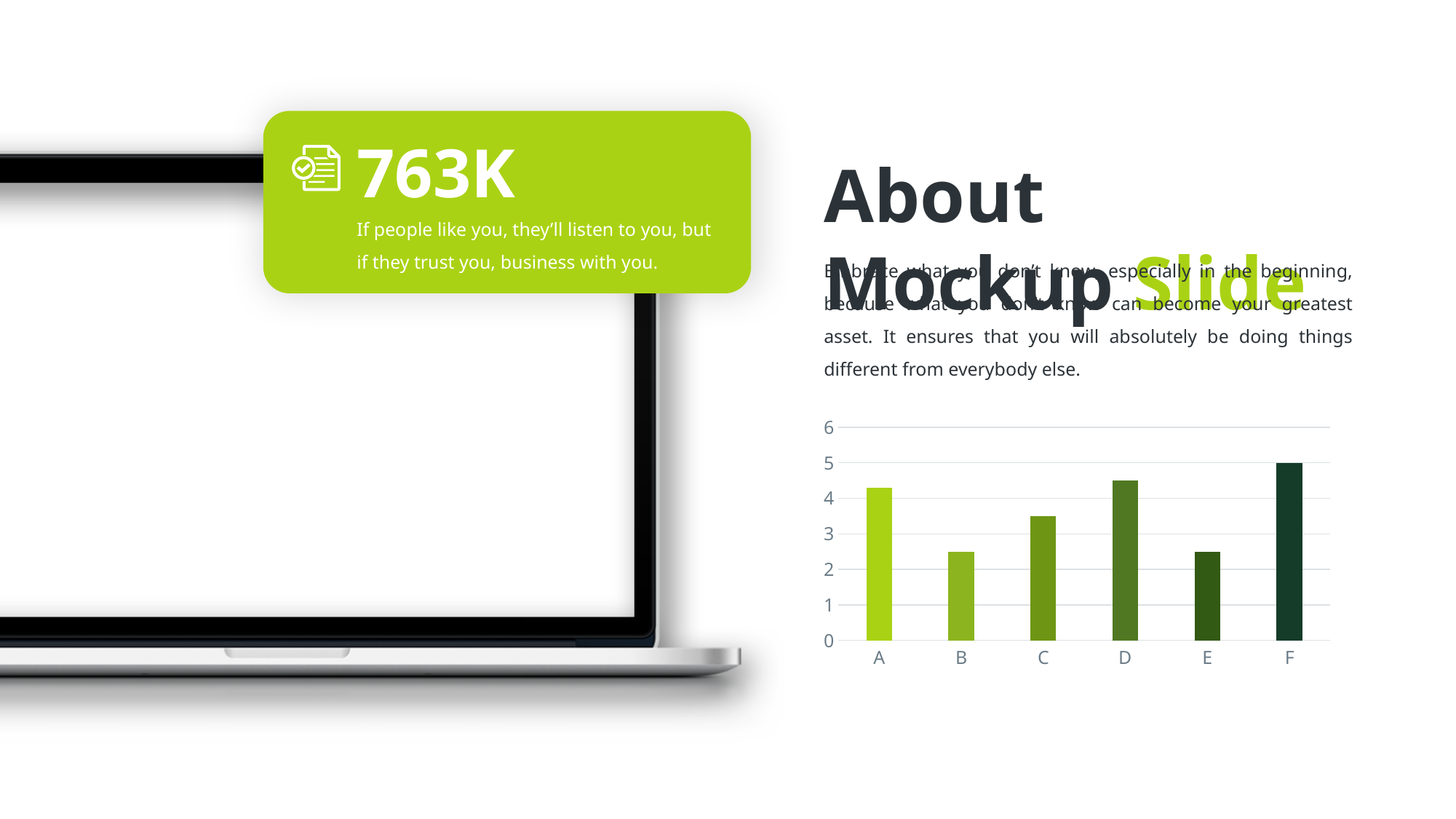
What kind of chart is shown on the slide? bar chart What colour family are the bars in the chart? green Is the value for E greater or less than 3? less Which is larger, the value for A or the value for B? A What is the value for category F in the bar chart? 5 Is the value for B greater or less than 3? less Which is larger, the value for D or the value for C? D Which category has the highest bar in the chart? F Is the value for D greater or less than 4? greater How many categories are shown on the x axis of the bar chart? 6